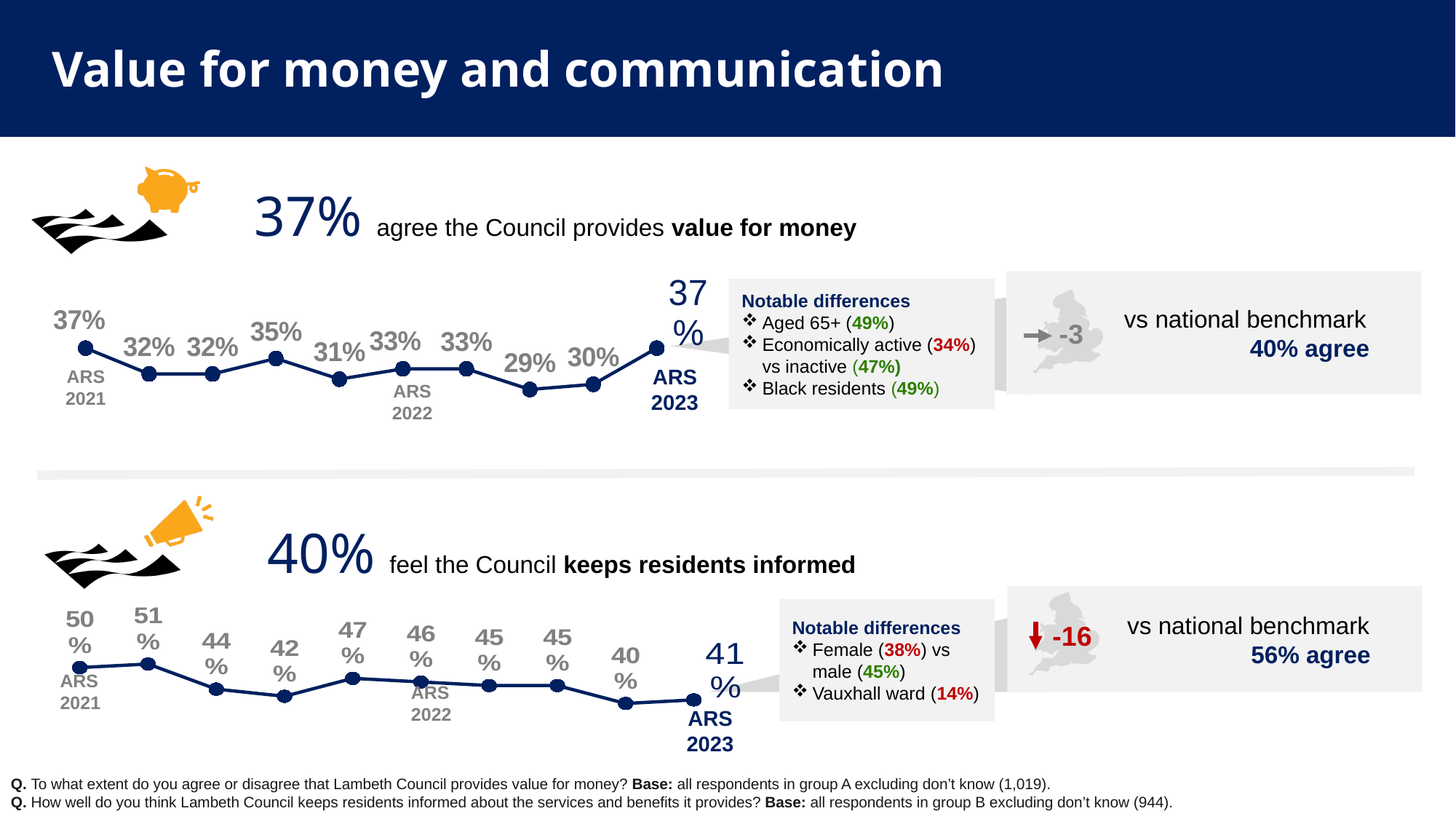
In the bottom chart (keeps residents informed), what is the value for ARS 2021? 50% In the top chart (value for money), what is the lowest value plotted? 29% In the bottom chart (keeps residents informed), which is larger: the ARS 2021 value or the ARS 2023 value? ARS 2021 In the bottom chart (keeps residents informed), do the values overall rise or fall from ARS 2021 to ARS 2023? fall In the top chart (value for money), what is the value for ARS 2021? 37% In the top chart (value for money), what is the difference between the ARS 2023 value and the ARS 2022 value? 4 percentage points What kind of chart is the bottom chart (keeps residents informed)? line chart In the top chart (value for money), how many data points are plotted? 10 In the top chart (value for money), what is the value for ARS 2022? 33% In the bottom chart (keeps residents informed), what is the highest value plotted? 51% What kind of chart is the top chart (value for money)? line chart In the bottom chart (keeps residents informed), what is the value for ARS 2023? 41%